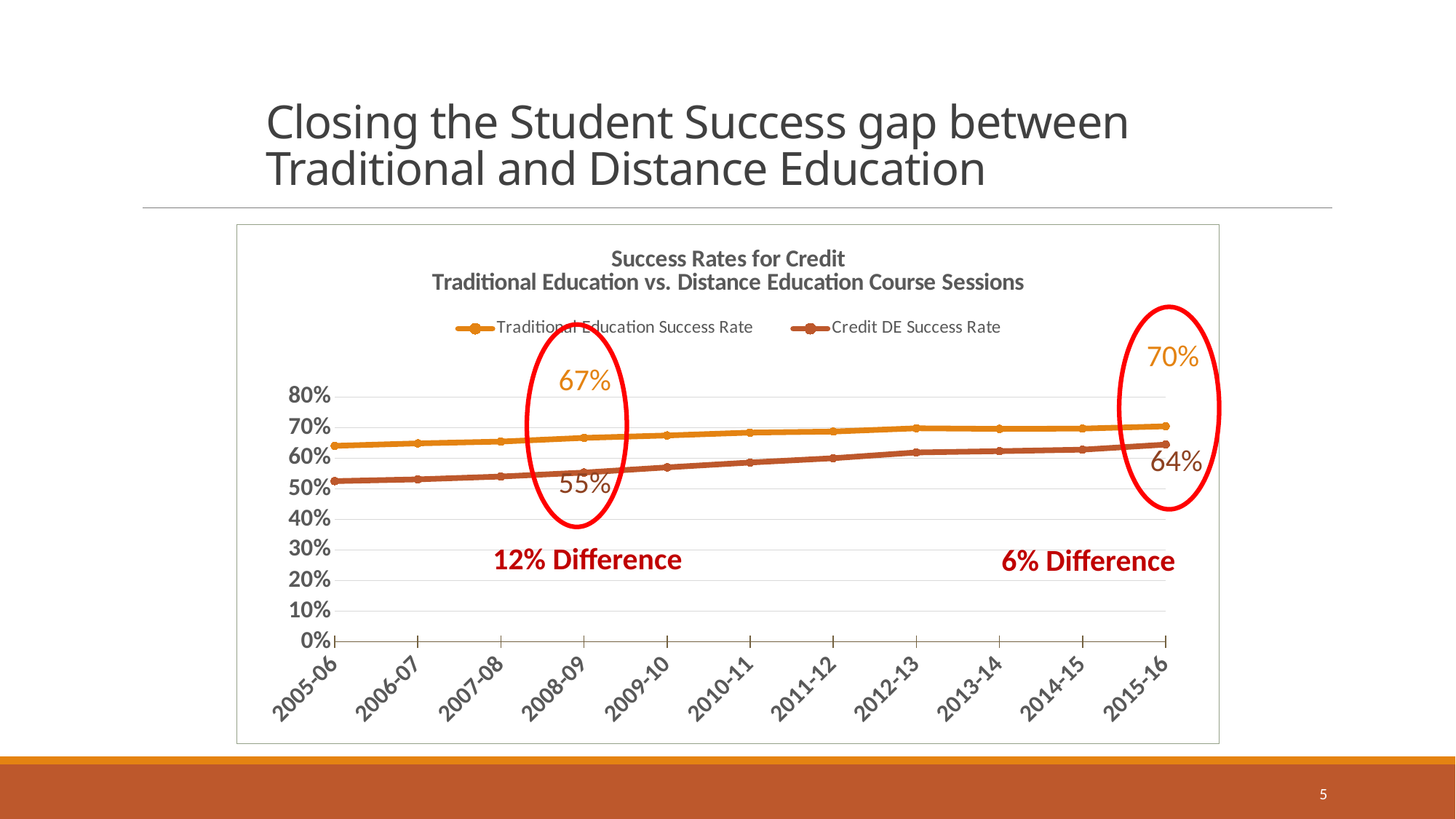
What is the Credit DE Success Rate for 2015-16? 64% Is the Credit DE Success Rate for 2005-06 greater or less than 60%? less What is the difference between the Traditional Education Success Rate and the Credit DE Success Rate in 2008-09? 12% How many series does the legend list? 2 What is the difference between the Traditional Education Success Rate and the Credit DE Success Rate in 2015-16? 6% Does the Credit DE Success Rate rise or fall from 2005-06 to 2015-16? rise Which series has the higher value in 2015-16, Traditional Education Success Rate or Credit DE Success Rate? Traditional Education Success Rate What is the Traditional Education Success Rate for 2008-09? 67% What is the Traditional Education Success Rate for 2015-16? 70% How many academic years are shown on the x axis? 11 What is the Credit DE Success Rate for 2008-09? 55% What kind of chart is shown on the slide? line chart